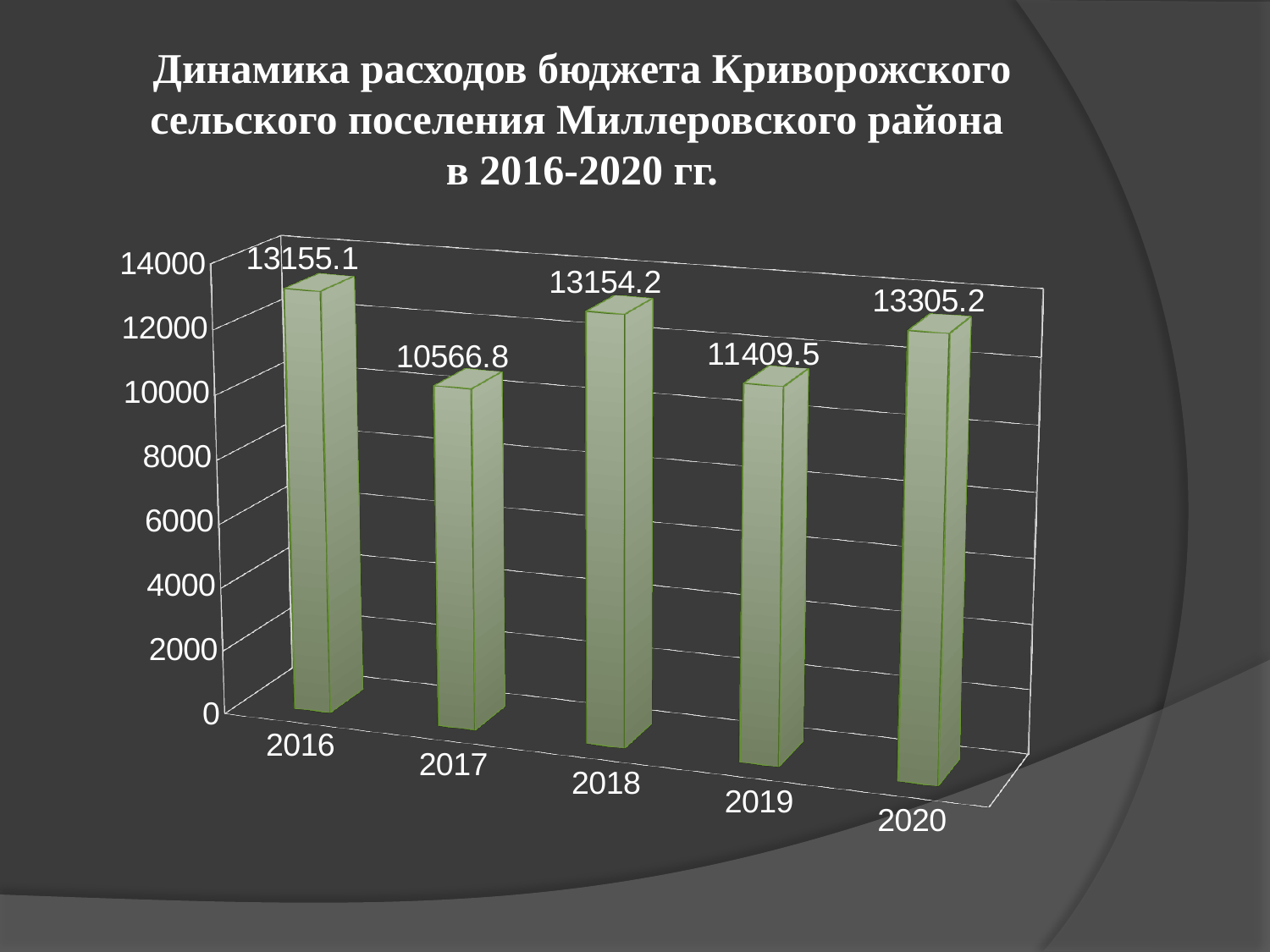
Which year has the highest value? 2020 Which year has the lowest value? 2017 Which is larger, the value for 2017 or the value for 2019? 2019 What is the value for 2017? 10566.8 What is the value for 2019? 11409.5 What kind of chart is shown on the slide? bar chart What is the value for 2020? 13305.2 Is the value for 2017 greater or less than 12000? less How many years are shown on the chart? 5 What is the difference between the values for 2019 and 2017? 842.7 What is the value for 2016? 13155.1 What is the difference between the values for 2020 and 2017? 2738.4